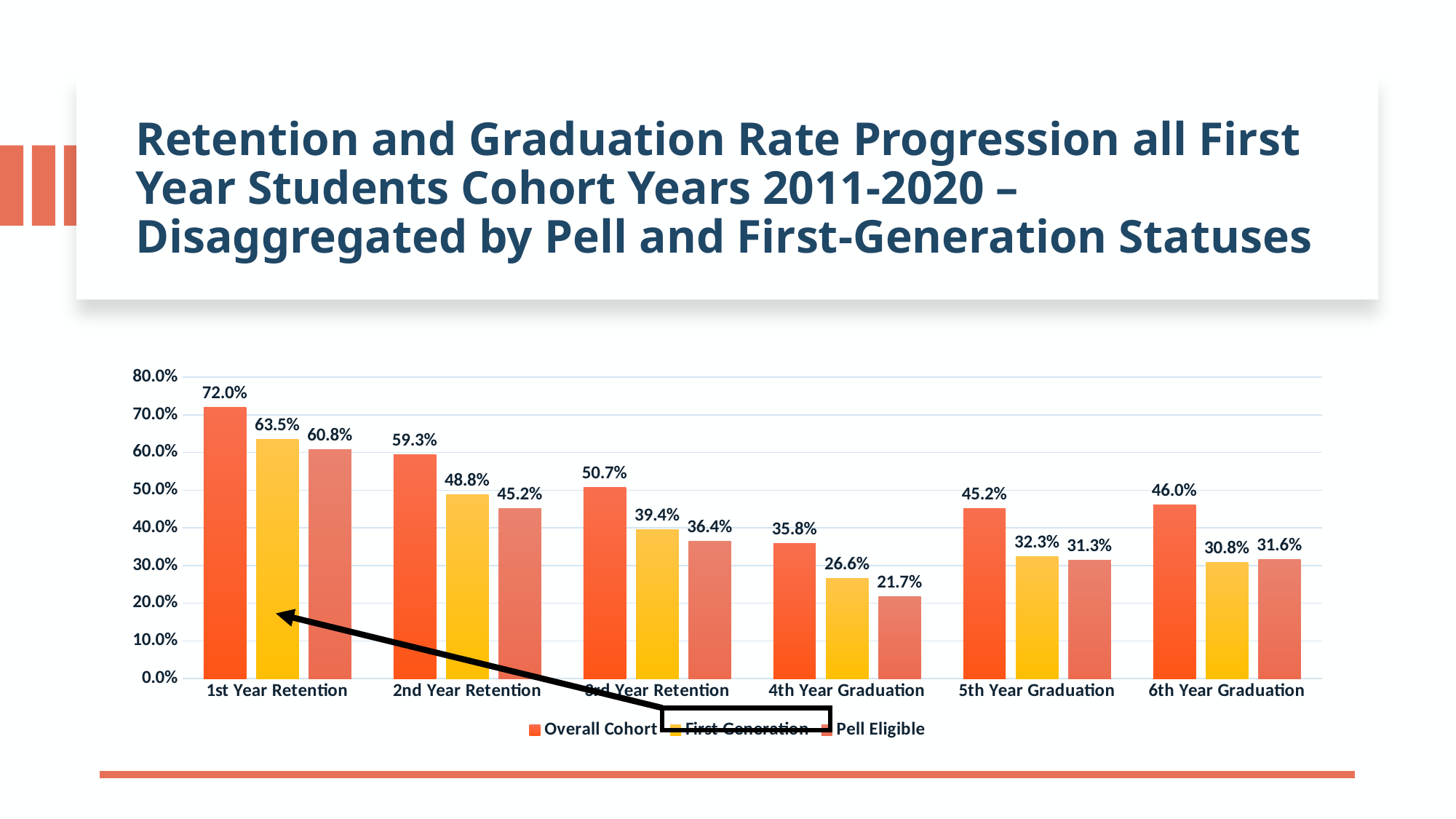
How many series does the legend list? 3 What is the difference between the Overall Cohort and Pell Eligible values for 4th Year Graduation? 14.1% Do the Overall Cohort values rise or fall from 1st Year Retention to 4th Year Graduation? Fall Which is larger for 6th Year Graduation: the First Generation value or the Pell Eligible value? Pell Eligible Which category has the lowest Pell Eligible value? 4th Year Graduation What is the Overall Cohort value for 1st Year Retention? 72.0% How many categories are shown on the x axis? 6 What kind of chart is shown on the slide? Bar chart What is the First Generation value for 4th Year Graduation? 26.6% Which series is shown in yellow in the legend? First Generation Which category has the highest First Generation value? 1st Year Retention What is the Pell Eligible value for 6th Year Graduation? 31.6%